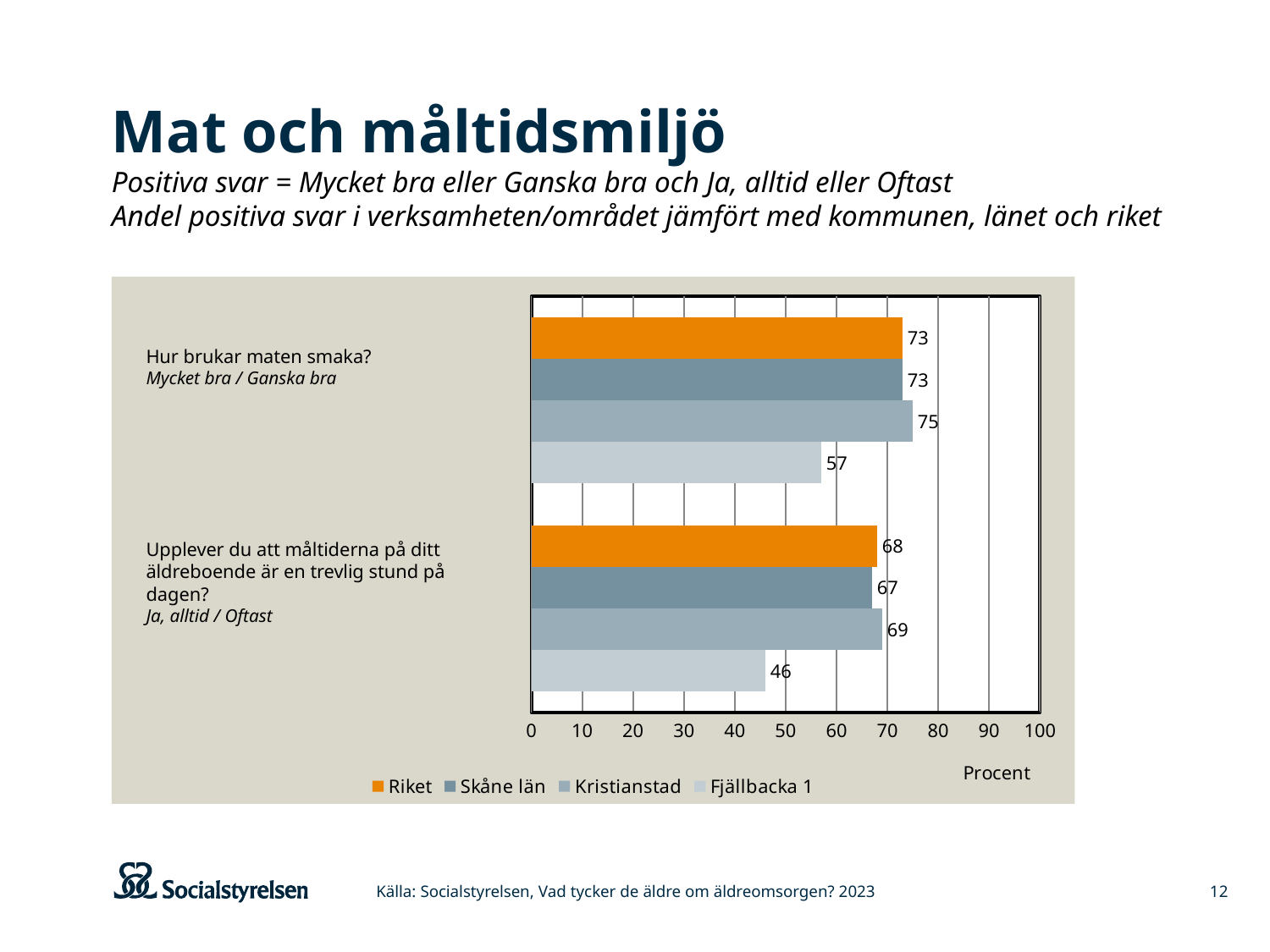
How many series does the legend list? 4 What is the difference between the Riket and Fjällbacka 1 values for the question "Upplever du att måltiderna på ditt äldreboende är en trevlig stund på dagen?"? 22 Which is larger for Fjällbacka 1: the value for "Hur brukar maten smaka?" or the value for "Upplever du att måltiderna på ditt äldreboende är en trevlig stund på dagen?"? Hur brukar maten smaka? Which series has the highest value for the question "Upplever du att måltiderna på ditt äldreboende är en trevlig stund på dagen?"? Kristianstad What is the difference between the Kristianstad and Fjällbacka 1 values for the question "Hur brukar maten smaka?"? 18 What is the value for Fjällbacka 1 for the question "Upplever du att måltiderna på ditt äldreboende är en trevlig stund på dagen?"? 46 What is the value for Riket for the question "Upplever du att måltiderna på ditt äldreboende är en trevlig stund på dagen?"? 68 What is the value for Kristianstad for the question "Hur brukar maten smaka?"? 75 What is the value for Fjällbacka 1 for the question "Hur brukar maten smaka?"? 57 What unit is shown on the x axis of the chart? Procent Which series has the lowest value for the question "Hur brukar maten smaka?"? Fjällbacka 1 What kind of chart is shown on the slide? bar chart